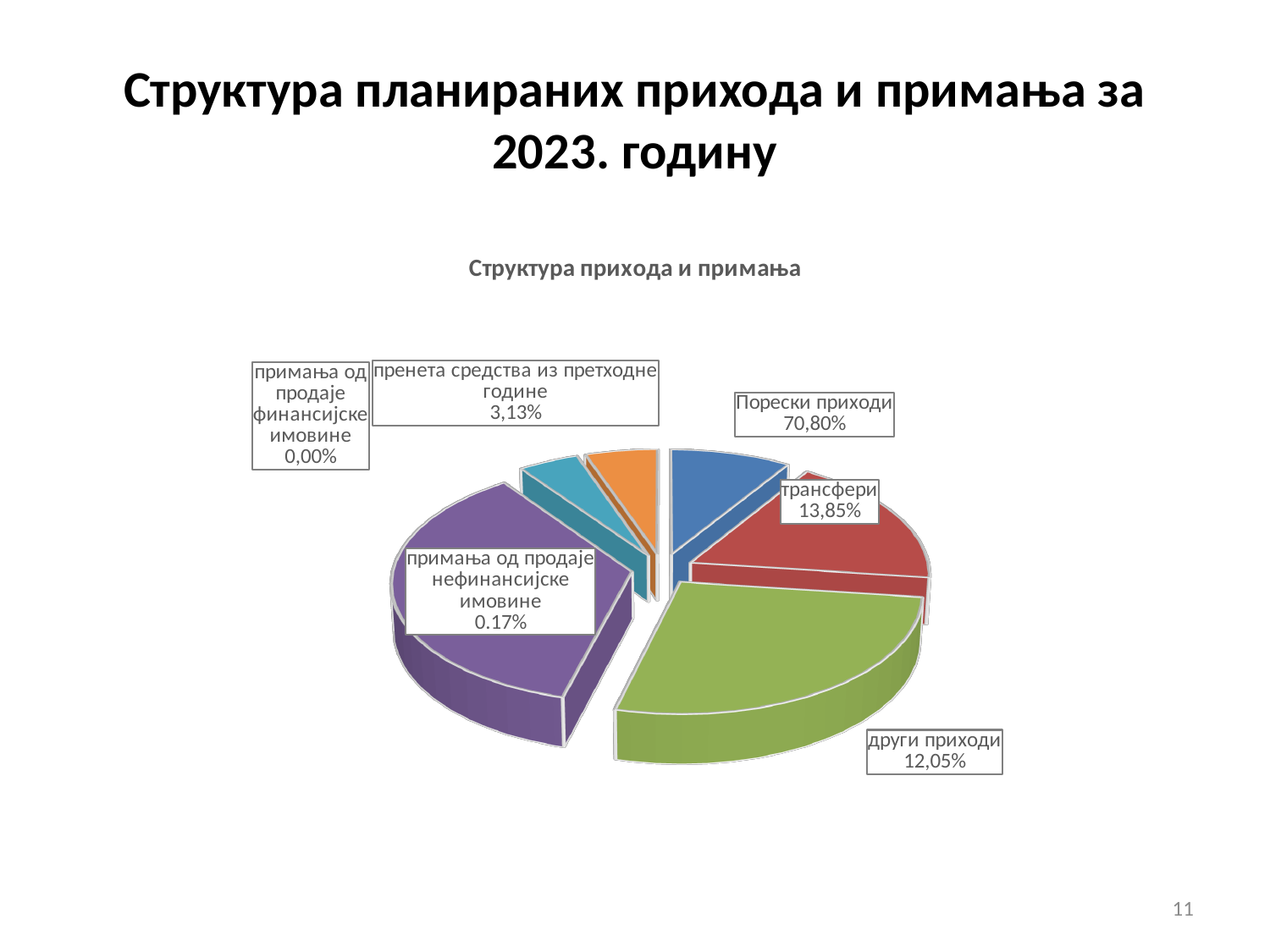
By how many percentage points does трансфери exceed други приходи according to the labels? 1,80 According to the data labels, which category has the largest share? Порески приходи According to the data labels, which category has the smallest share? примања од продаје финансијске имовине What percentage is shown for трансфери? 13,85% What value is labelled for други приходи? 12,05% What is the title of the chart? Структура прихода и примања What value is labelled for примања од продаје нефинансијске имовине? 0.17% What percentage is shown for примања од продаје финансијске имовине? 0,00% What share of the pie does Порески приходи have? 70,80% How many categories are labelled on the pie chart? 6 What percentage is shown for пренета средства из претходне године? 3,13% What kind of chart is shown on the slide? Pie chart